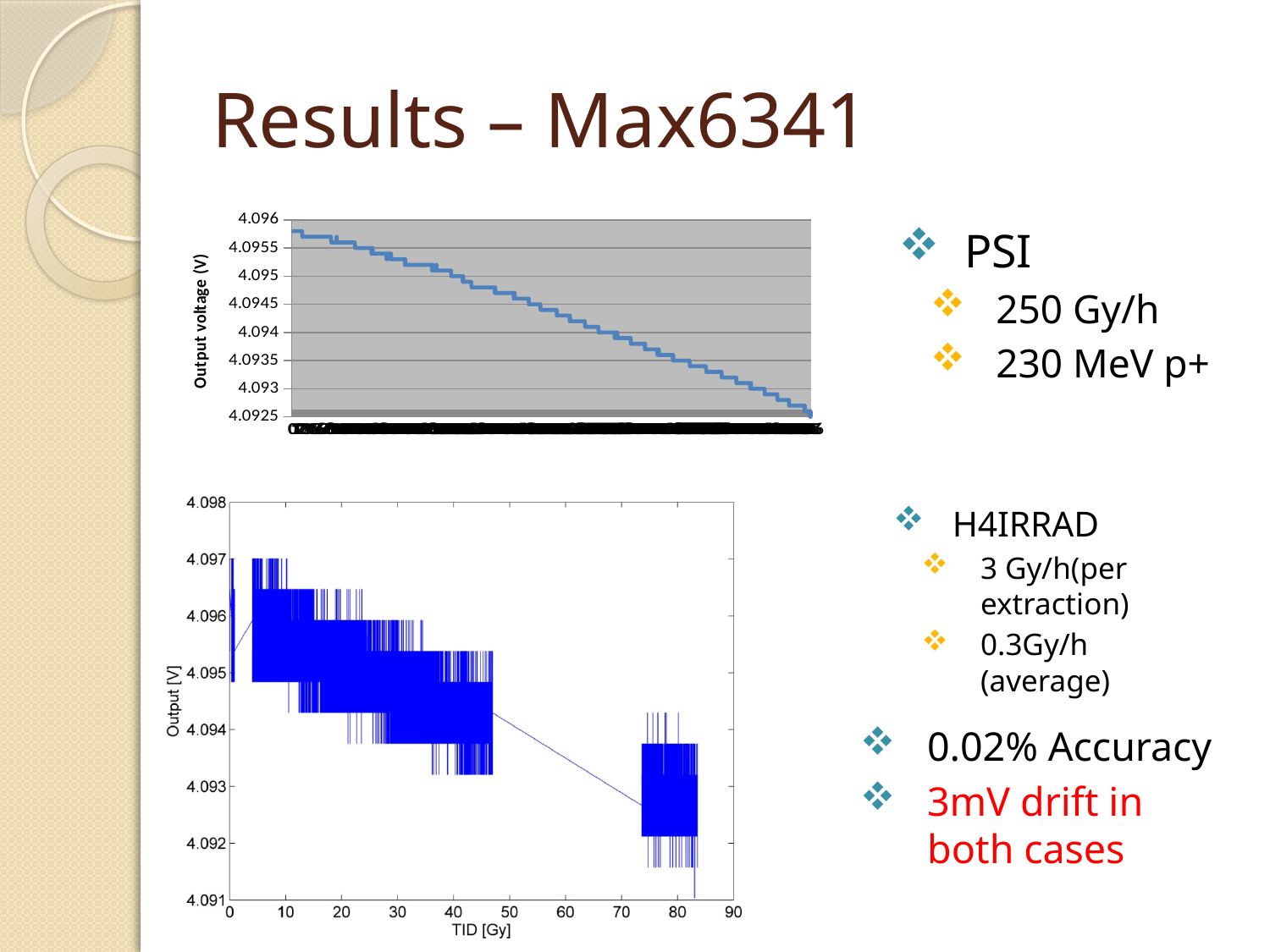
In the top chart, does the output voltage rise or fall along the x axis? fall In the bottom chart, is the output at a TID of 10 Gy greater or less than 4.094? greater In the bottom chart, is the output at a TID of 40 Gy greater or less than 4.096? less In the top chart, is the output voltage at the end of the line greater or less than 4.093? less In the bottom chart, does the output rise or fall as TID increases? fall How many charts are shown on the slide? 2 What kind of chart is the top chart on the slide? line chart What is the label of the x axis of the bottom chart? TID [Gy] What kind of chart is the bottom chart on the slide? line chart What is the label of the y axis of the top chart? Output voltage (V)